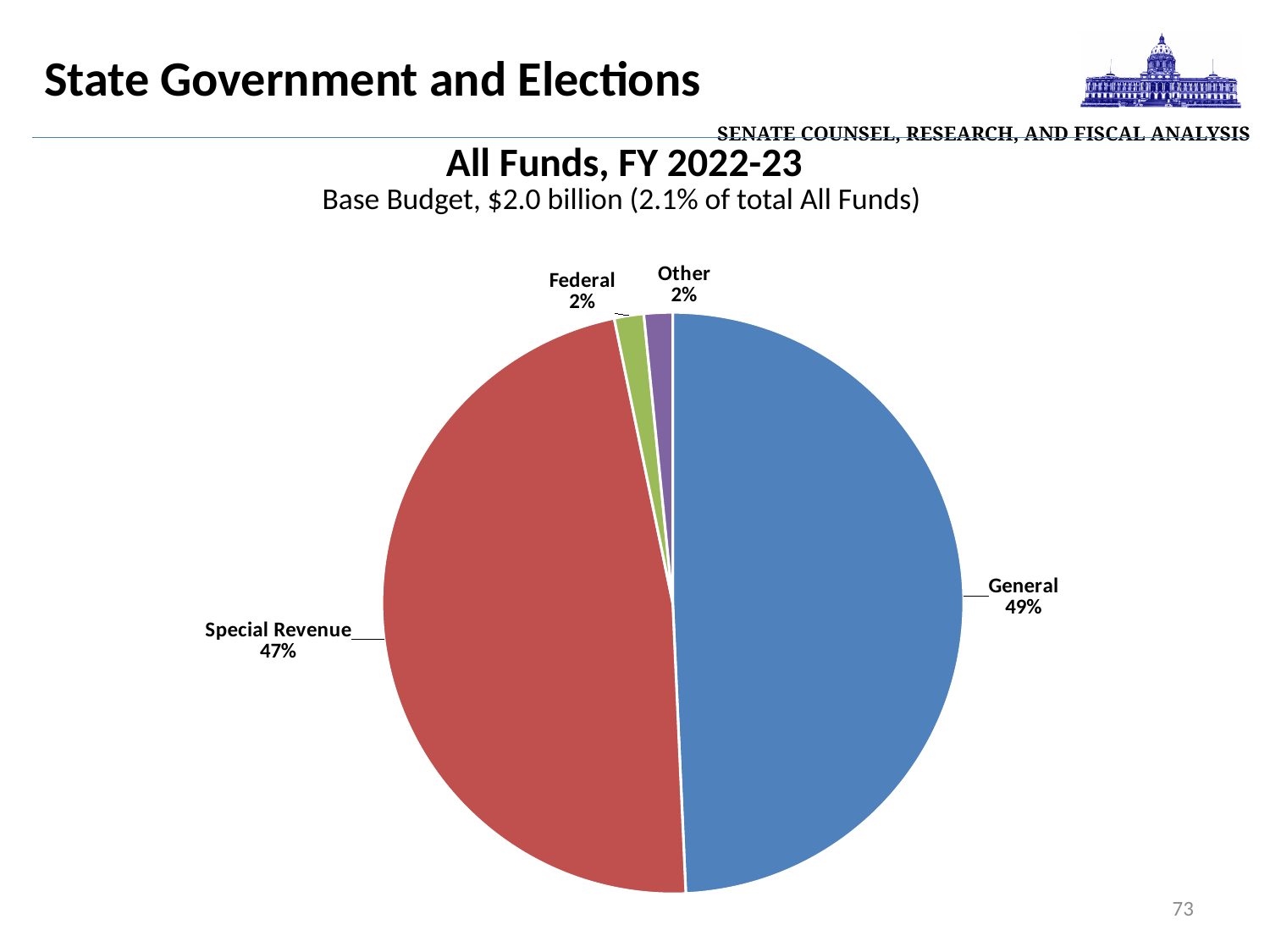
Which category has the largest share of the pie? General What kind of chart is shown on the slide? Pie chart How many slices does the pie chart have? 4 What is the title of the chart? All Funds, FY 2022-23 What share of the pie does Special Revenue represent? 47% What share of the pie does Federal represent? 2% What share of the pie does Other represent? 2% What is the combined share of the Federal and Other slices? 4% What is the difference in percentage points between the General and Special Revenue shares? 2% What colour is the Special Revenue slice? Red Which is larger, the General share or the Special Revenue share? General